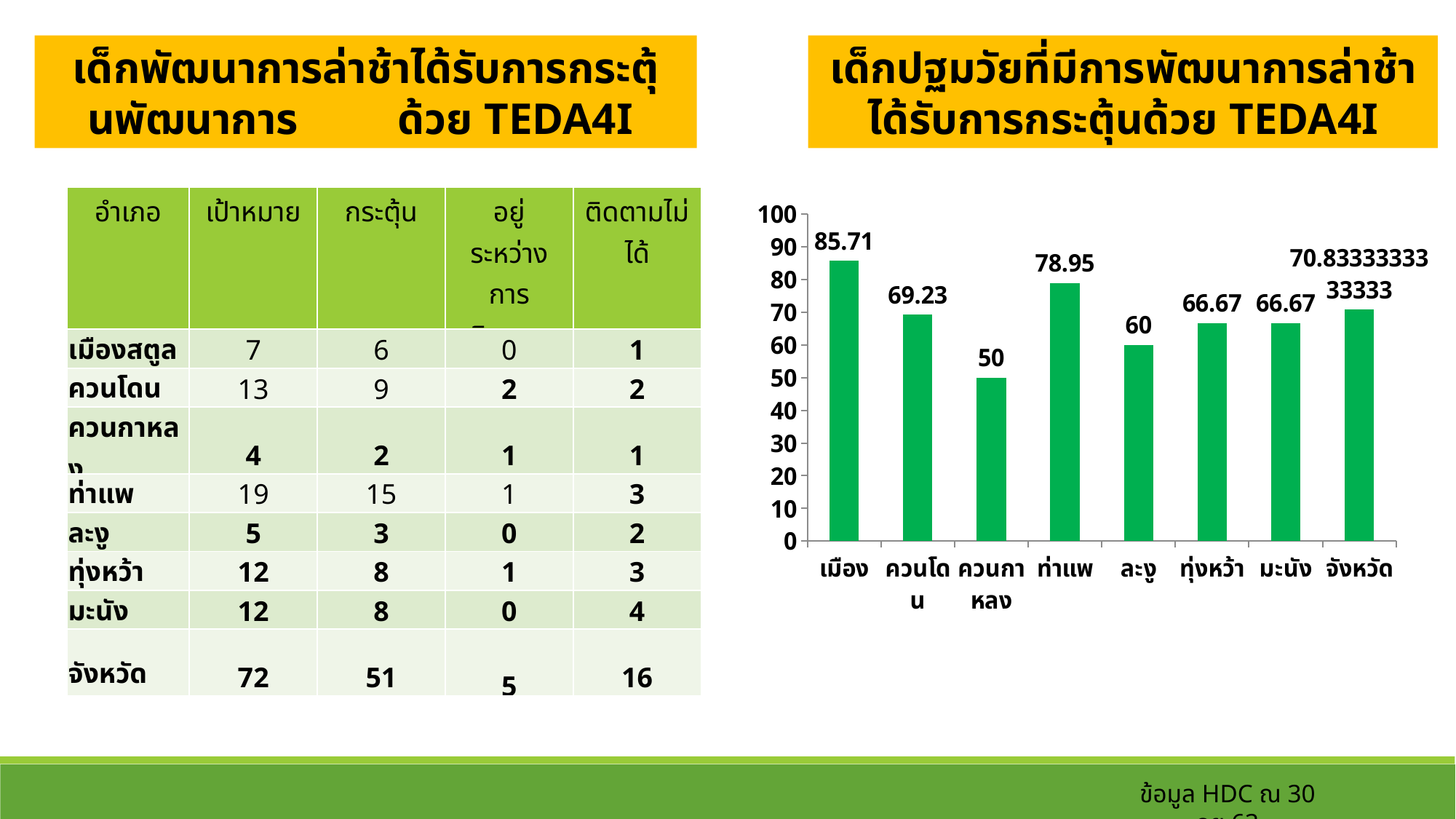
In the bar chart, which category has the lowest value? ควนกาหลง In the bar chart, which is larger, the value for ท่าแพ or the value for ควนโดน? ท่าแพ In the bar chart, is the value for ละงู greater or less than 70? less In the bar chart, what is the value for ละงู? 60 In the bar chart, what value is shown for ทุ่งหว้า and มะนัง? 66.67 In the bar chart, what is the value for เมือง? 85.71 In the bar chart, what is the value for ควนโดน? 69.23 In the bar chart, what is the difference between the values for เมือง and ควนกาหลง? 35.71 What type of chart is shown on the right side of the slide? bar chart In the bar chart, what is the value for ท่าแพ? 78.95 In the bar chart, which category has the highest value? เมือง How many bars are plotted in the bar chart? 8